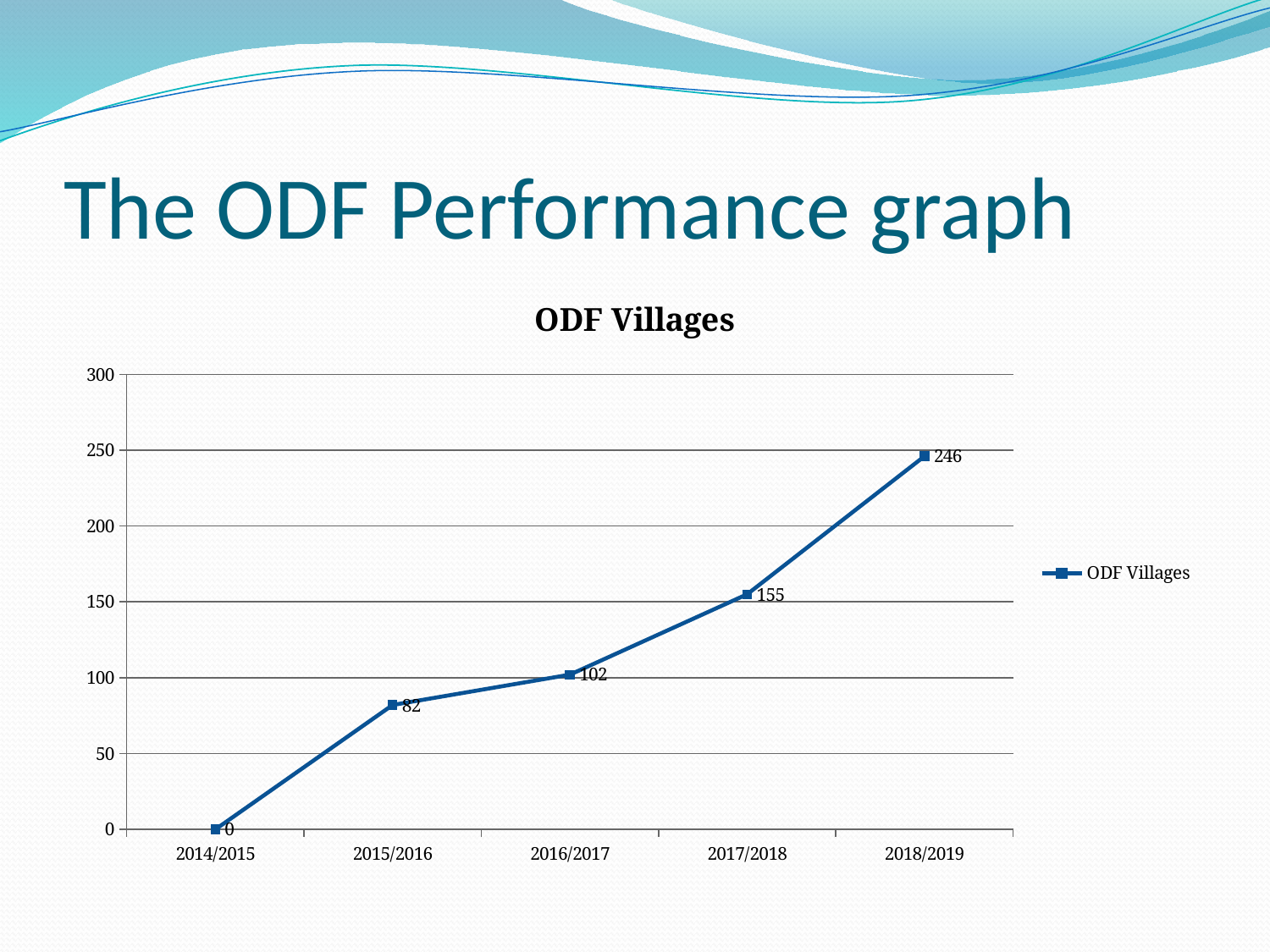
Which year has the highest number of ODF Villages? 2018/2019 What is the value for ODF Villages in 2017/2018? 155 Which year has the lowest number of ODF Villages? 2014/2015 Is the value for 2017/2018 greater or less than 150? greater What is the difference between the ODF Villages values for 2016/2017 and 2015/2016? 20 What is the difference between the ODF Villages values for 2018/2019 and 2017/2018? 91 How many years are plotted on the x axis? 5 What is the value for ODF Villages in 2015/2016? 82 Do the ODF Villages values rise or fall from 2014/2015 to 2018/2019? rise What is the value for ODF Villages in 2018/2019? 246 What kind of chart is shown on the slide? line chart Which is larger, the value for 2016/2017 or the value for 2015/2016? 2016/2017